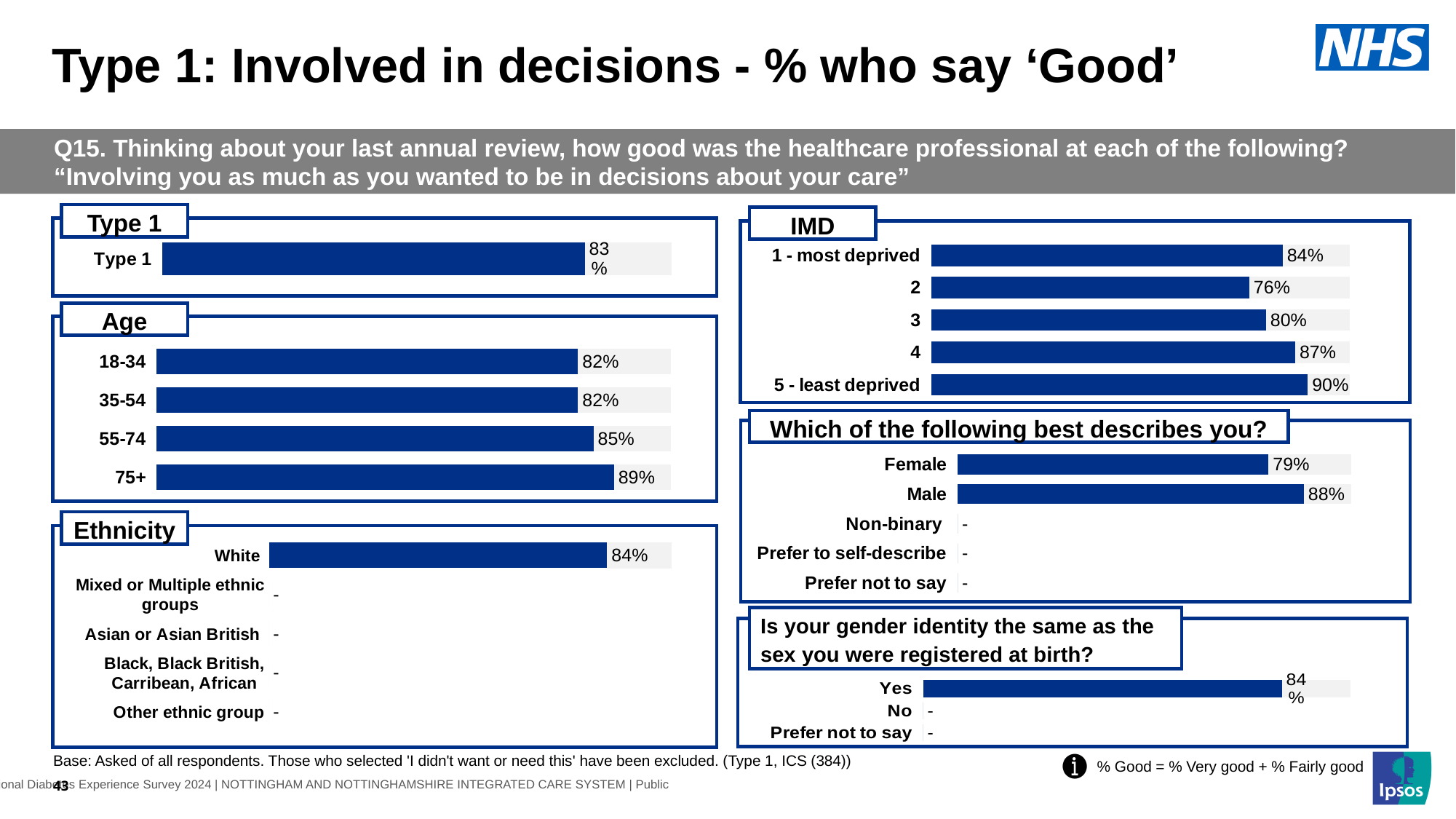
In the Type 1 chart, what is the value shown for Type 1? 83% In the 'Which of the following best describes you?' chart, which is larger, Female or Male? Male What type of chart is used in the IMD section? Bar chart In the IMD chart, which category has the lowest value? 2 In the IMD chart, what is the value for '5 - least deprived'? 90% In the Ethnicity chart, what is the value for White? 84% In the Age chart, what is the difference between the 55-74 and 18-34 groups? 3 percentage points How many categories are listed in the IMD chart? 5 In the IMD chart, what is the difference between '5 - least deprived' and '1 - most deprived'? 6 percentage points In the 'Which of the following best describes you?' chart, what is the value for Female? 79% In the Age chart, what is the value for the 75+ group? 89% In the Age chart, which age group has the highest value? 75+